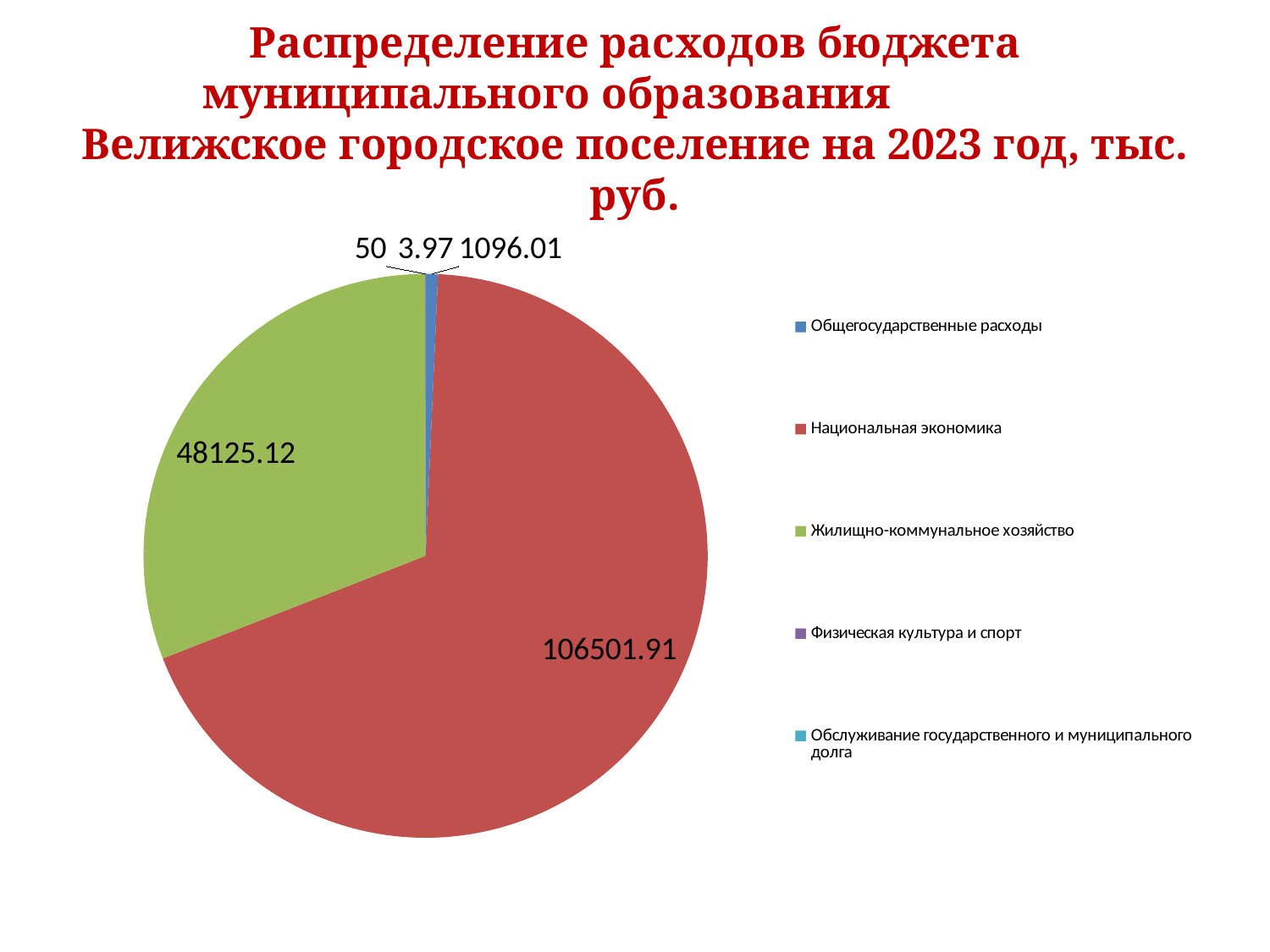
What is the value for Жилищно-коммунальное хозяйство? 48125.12 What year does the chart title refer to? 2023 What colour is the slice for Национальная экономика? Red What is the value for Физическая культура и спорт? 50 What type of chart is shown on the slide? Pie chart How many categories does the legend list? 5 Which is larger, Жилищно-коммунальное хозяйство or Общегосударственные расходы? Жилищно-коммунальное хозяйство What is the difference between Жилищно-коммунальное хозяйство and Общегосударственные расходы? 47029.11 What is the value for Национальная экономика? 106501.91 What is the difference between Национальная экономика and Жилищно-коммунальное хозяйство? 58376.79 Which category has the largest slice of the pie? Национальная экономика What is the value for Общегосударственные расходы? 1096.01